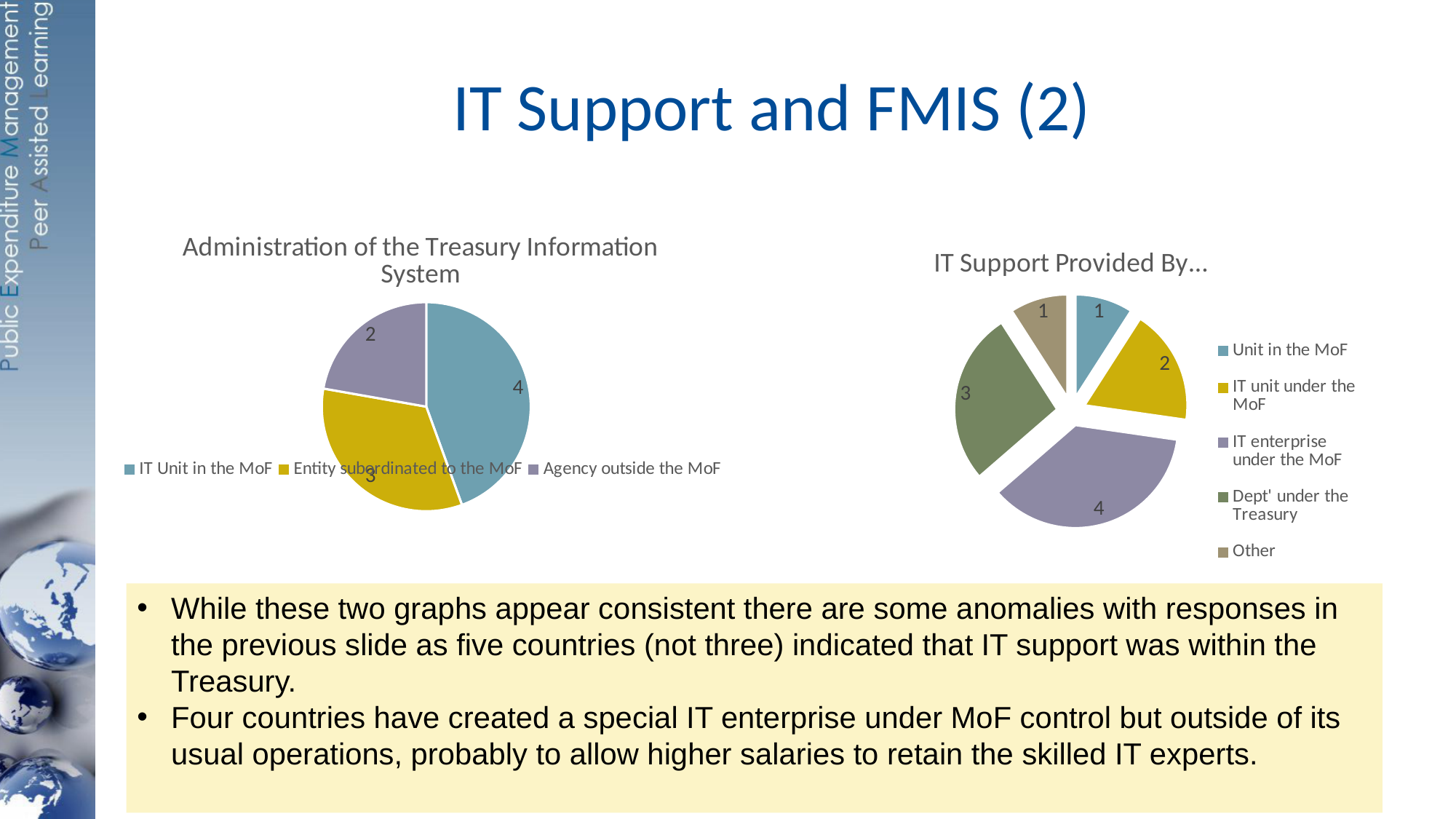
In the 'IT Support Provided By...' chart, what is the difference between IT enterprise under the MoF and Other? 3 In the 'Administration of the Treasury Information System' chart, what is the value for Agency outside the MoF? 2 How many entries does the legend of the 'IT Support Provided By...' chart list? 5 In the 'IT Support Provided By...' chart, what is the value for Dept' under the Treasury? 3 In the 'Administration of the Treasury Information System' chart, what is the difference between IT Unit in the MoF and Entity subordinated to the MoF? 1 In the 'Administration of the Treasury Information System' chart, which category has the largest slice? IT Unit in the MoF What kind of chart is 'IT Support Provided By...'? Pie chart In the 'IT Support Provided By...' chart, what is the value for IT enterprise under the MoF? 4 In the 'IT Support Provided By...' chart, which category has the largest slice? IT enterprise under the MoF How many categories does the 'Administration of the Treasury Information System' chart show? 3 In the 'Administration of the Treasury Information System' chart, what is the value for IT Unit in the MoF? 4 In the 'IT Support Provided By...' chart, which is larger: IT unit under the MoF or Dept' under the Treasury? Dept' under the Treasury